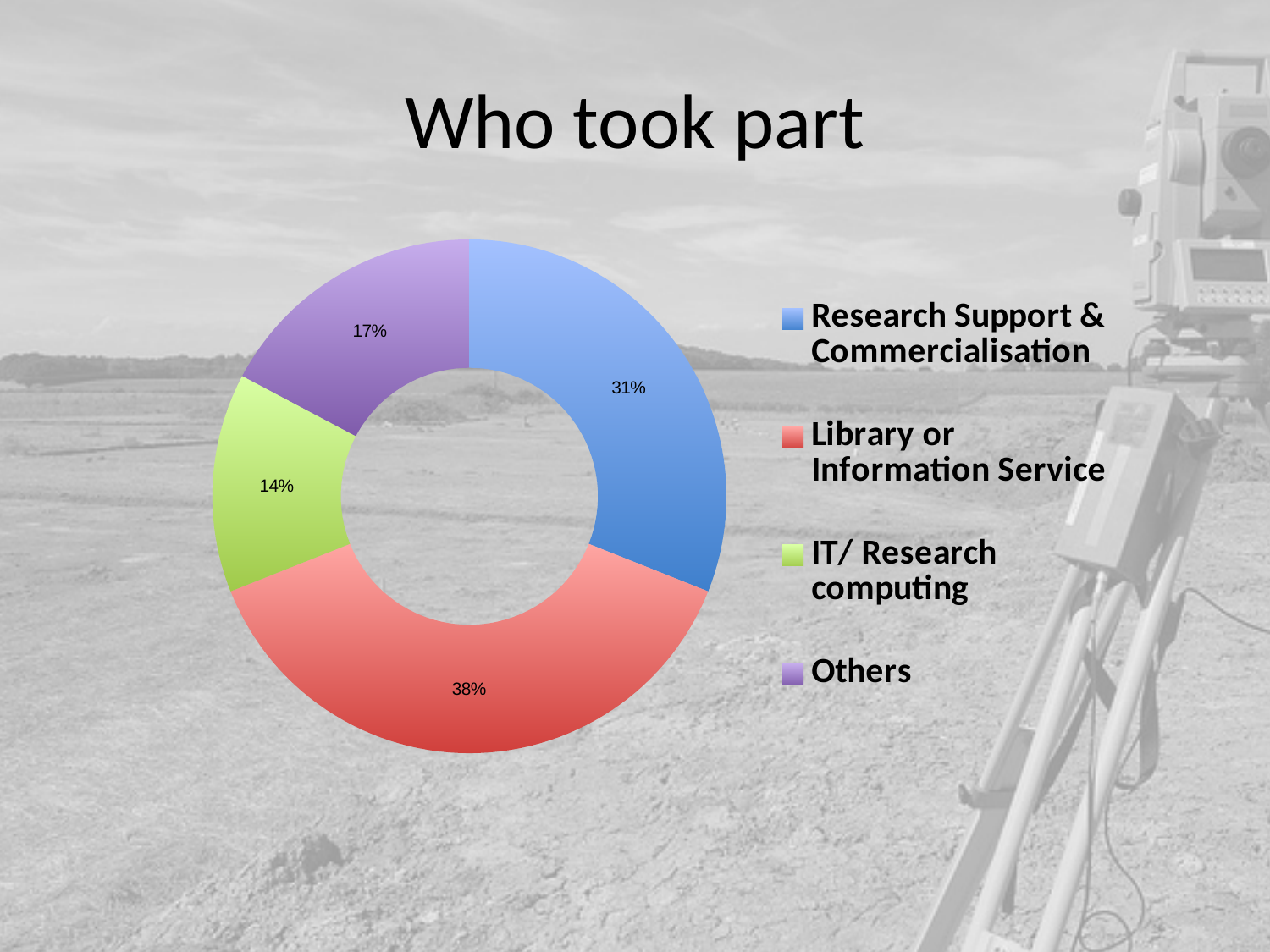
What is the title of the slide containing the chart? Who took part What colour represents Library or Information Service in the chart? Red What is the difference in percentage points between Library or Information Service and Research Support & Commercialisation? 7 How many groups are shown in the chart? 4 What share of participants were from Library or Information Service? 38% Which group has the smallest share of participants? IT/ Research computing Which group has the largest share of participants? Library or Information Service What share of participants were from IT/ Research computing? 14% What share of participants were from Research Support & Commercialisation? 31% What share of participants fall under Others? 17% Which is larger: the share for Others or the share for IT/ Research computing? Others What kind of chart is shown on the slide? Pie chart (doughnut)